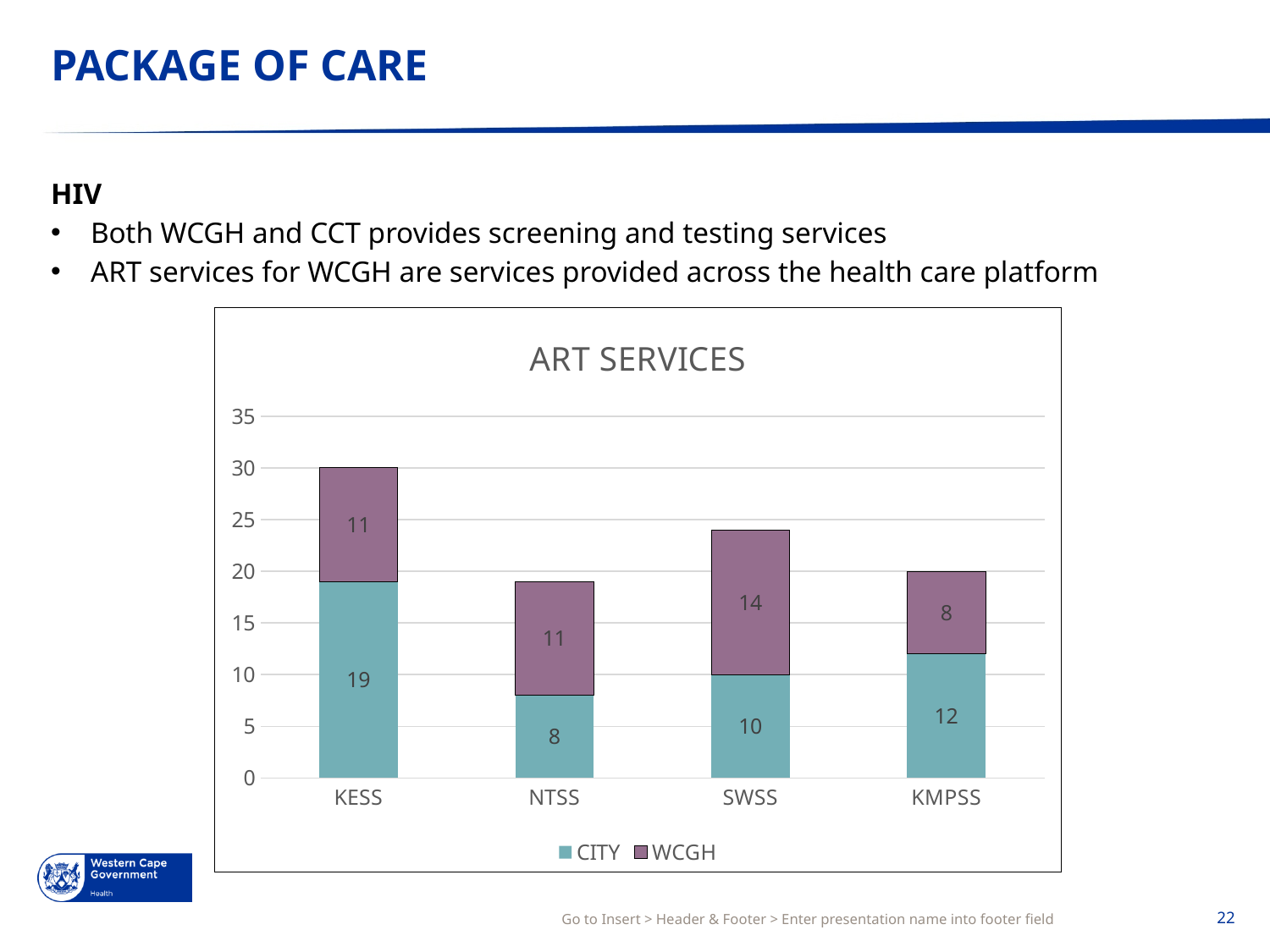
What is the CITY value for KESS? 19 What is the title of the chart? ART SERVICES How many categories are shown on the x axis? 4 What is the WCGH value for SWSS? 14 What is the total of the stacked bar for KESS? 30 What is the total of the stacked bar for NTSS? 19 Which is larger, the WCGH value for SWSS or the WCGH value for KMPSS? SWSS Which category has the lowest WCGH value? KMPSS What is the CITY value for KMPSS? 12 How many series does the legend list? 2 What is the difference between the CITY values for KESS and NTSS? 11 Which category has the highest CITY value? KESS